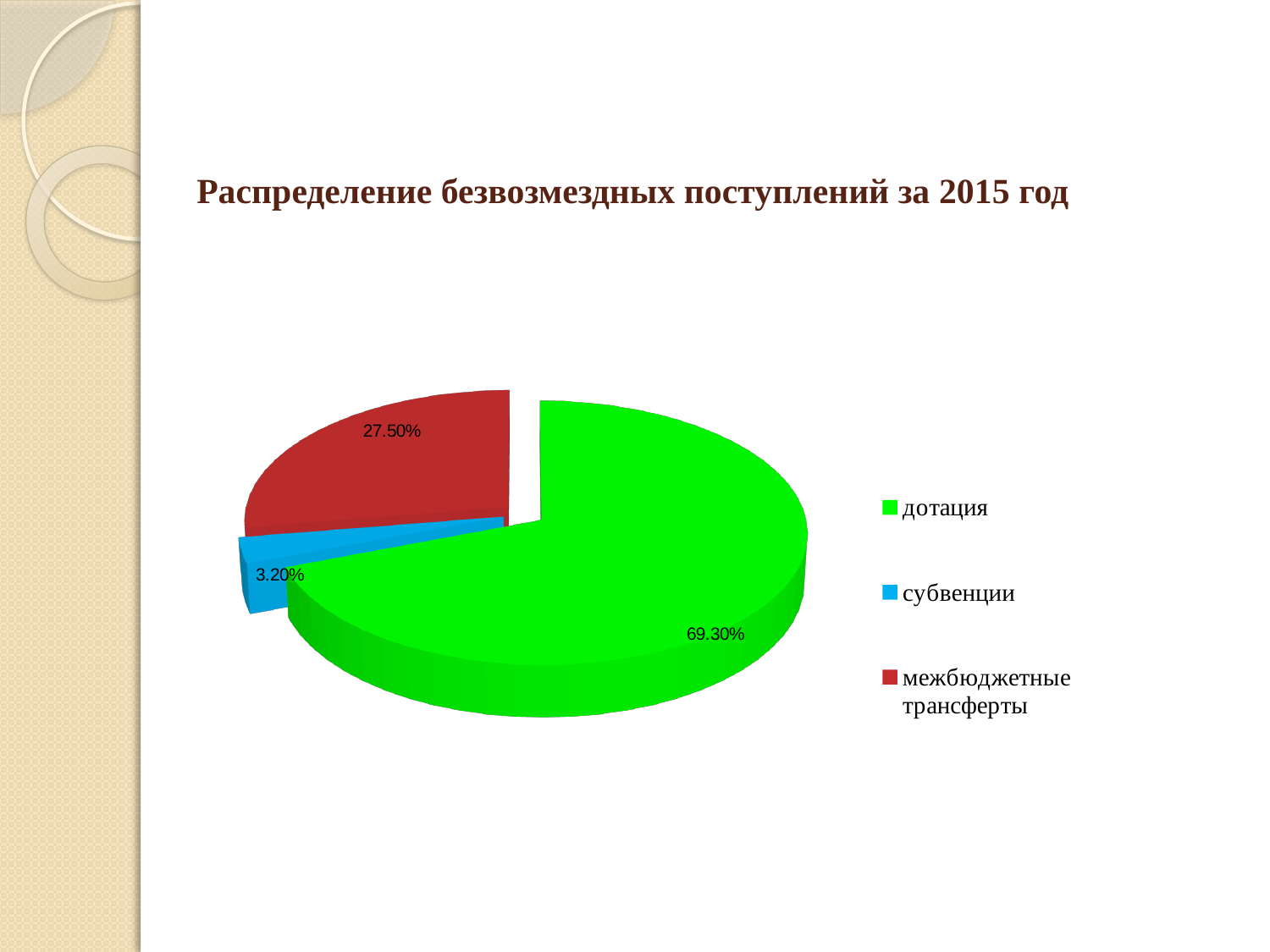
What kind of chart is shown on the slide? pie chart What share of the pie does межбюджетные трансферты have? 27.50% What colour is the slice for субвенции? blue Which category has the smallest slice of the pie? субвенции Which is larger, the share for субвенции or the share for межбюджетные трансферты? межбюджетные трансферты What is the difference in percentage points between межбюджетные трансферты and субвенции? 24.30 What share of the pie does дотация have? 69.30% How many slices does the pie chart have? 3 What is the difference in percentage points between дотация and межбюджетные трансферты? 41.80 What is the title of the slide? Распределение безвозмездных поступлений за 2015 год What share of the pie does субвенции have? 3.20% Which category has the largest slice of the pie? дотация